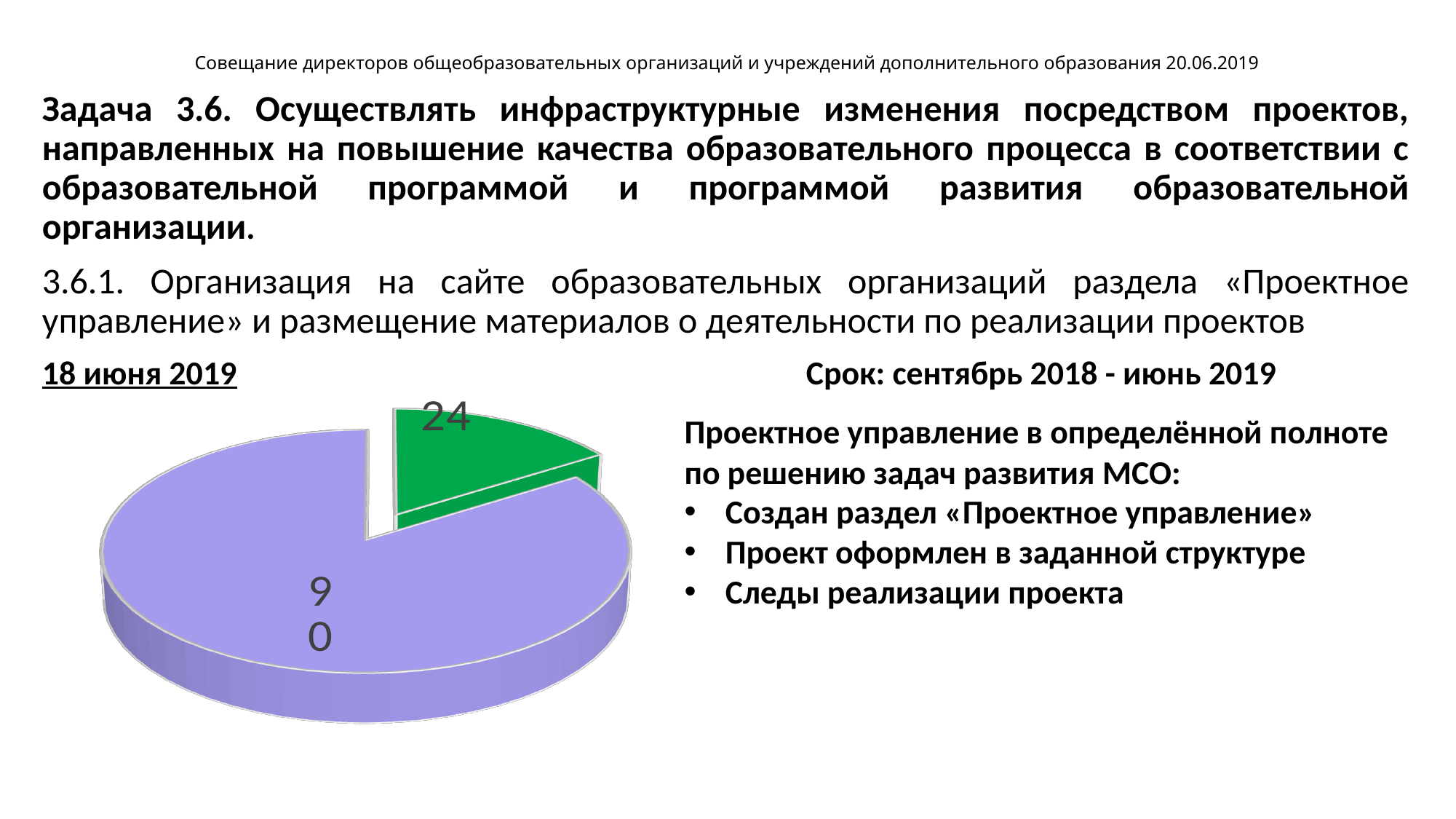
Which slice of the pie chart is the smallest? the green slice (24) Which is larger in the pie chart, the purple slice or the green slice? the purple slice What value is printed on the purple slice of the pie chart? 90 What value is printed on the green slice of the pie chart? 24 How many slices does the pie chart have? 2 What colour is the slice labelled 24? green What kind of chart is shown on the slide? pie chart What date is written above the pie chart? 18 июня 2019 What is the total of the two values shown in the pie chart? 114 Is the value of the green slice greater or less than 50? less Which slice of the pie chart is the largest? the purple slice (90) What is the difference between the values of the purple slice and the green slice? 66